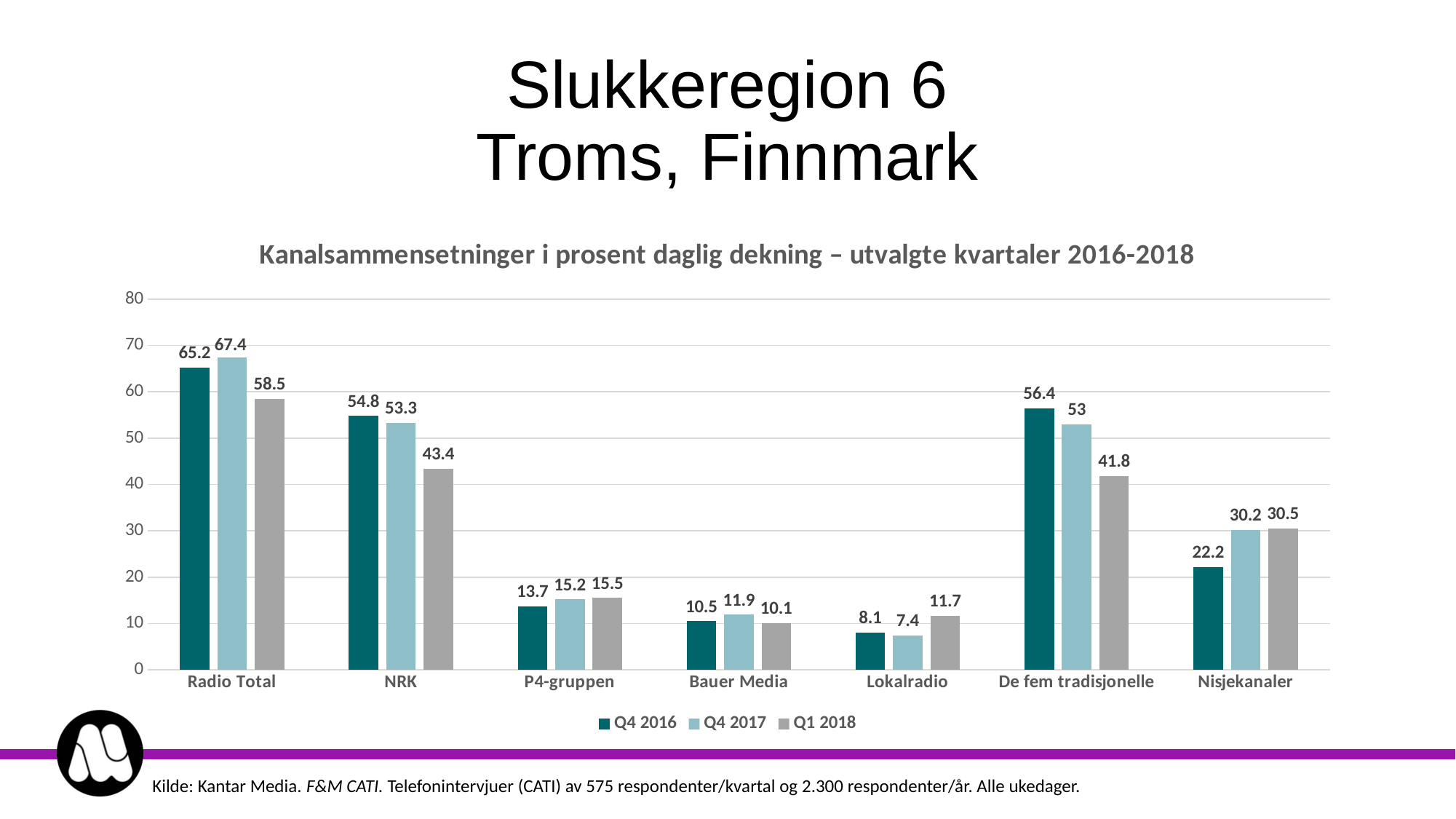
What kind of chart is shown on the slide? Bar chart Which is larger for Bauer Media: the Q4 2017 value or the Q1 2018 value? Q4 2017 Which category has the highest Q1 2018 value? Radio Total Do the values for NRK rise or fall from Q4 2016 to Q1 2018? Fall Which category has the lowest Q4 2017 value? Lokalradio How many series does the legend list? 3 How many categories are shown on the x axis? 7 What is the difference between the Q4 2016 and Q1 2018 values for De fem tradisjonelle? 14.6 What is the title of the chart? Kanalsammensetninger i prosent daglig dekning – utvalgte kvartaler 2016-2018 What is the Q1 2018 value for NRK? 43.4 What is the Q4 2016 value for Lokalradio? 8.1 What is the Q4 2017 value for Radio Total? 67.4